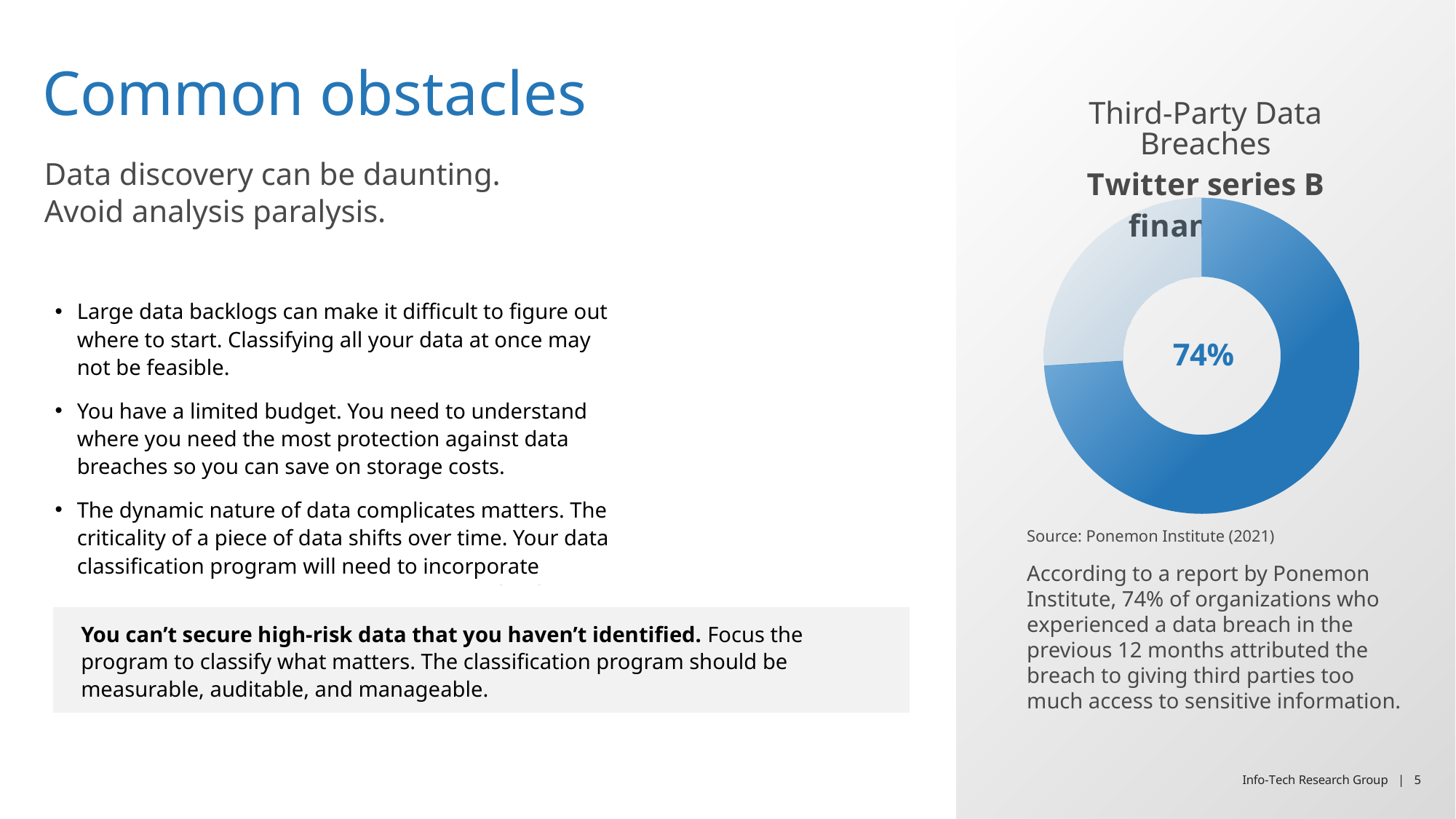
What percentage value is printed in the centre of the doughnut chart? 74% Is the light blue slice of the doughnut chart greater or less than 50% of the whole? less How many slices does the doughnut chart have? 2 Which slice of the doughnut chart is larger, the dark blue one or the light blue one? dark blue Which slice of the doughnut chart is the smallest? the light blue slice What is the title of the chart on the slide? Third-Party Data Breaches What source is cited beneath the doughnut chart? Ponemon Institute (2021) What kind of chart is shown on the right side of the slide? doughnut chart What share of the doughnut chart does the dark blue slice represent? 74%